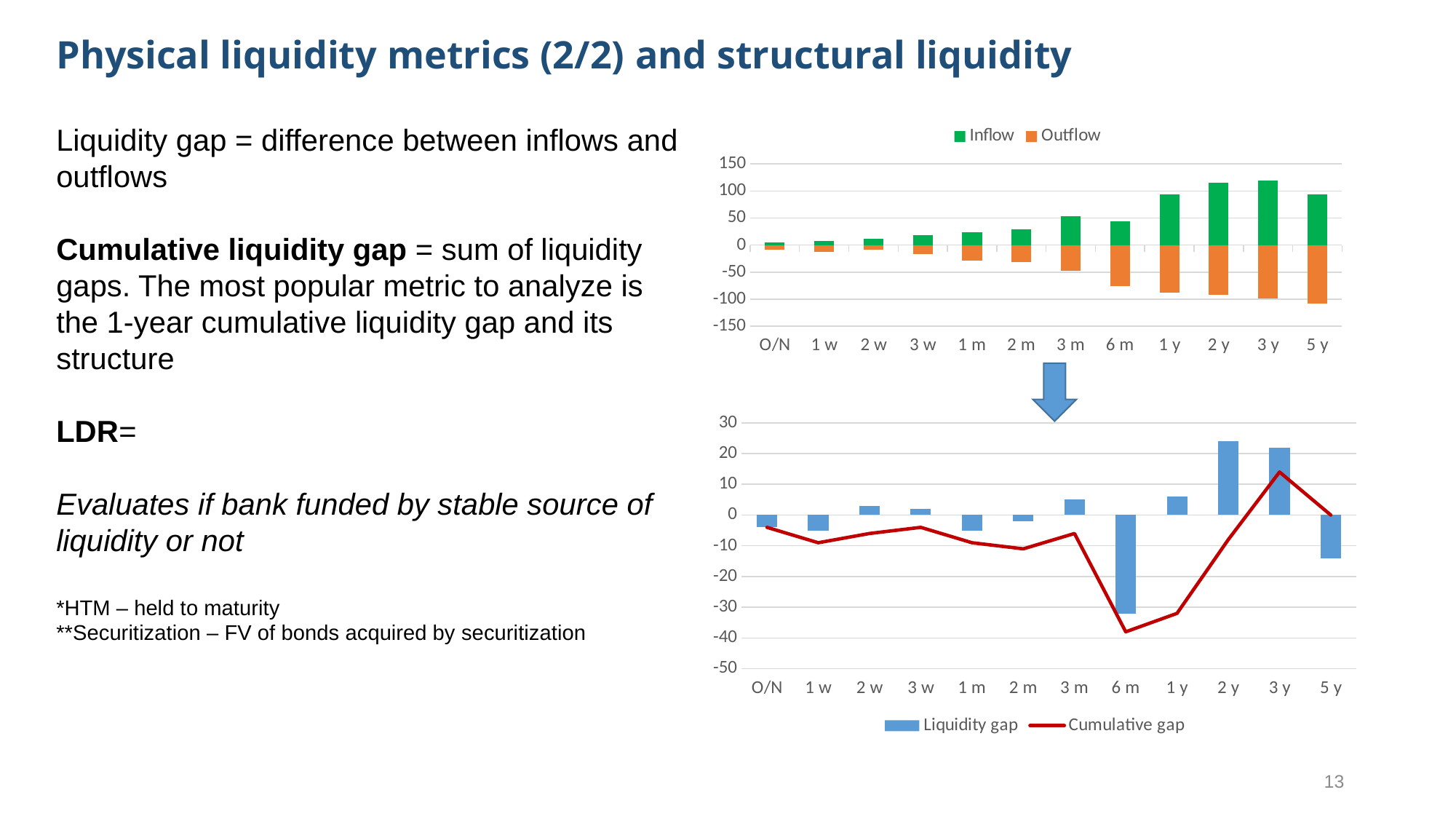
In the top chart, which series is shown in green? Inflow In the bottom chart, is the Liquidity gap for 6 m greater or less than -20? less How many series does the legend of the top chart list? 2 In the bottom chart, which series is drawn as a red line? Cumulative gap What kind of chart is the top chart (Inflow/Outflow)? bar chart In the top chart, is the Outflow value for 6 m greater or less than -50? less In the bottom chart, which category has the highest Cumulative gap? 3 y In the top chart, is the Inflow value for 2 m greater or less than 50? less In the bottom chart, which category has the lowest Liquidity gap? 6 m In the bottom chart, which is larger, the Liquidity gap for 2 y or for 6 m? 2 y How many categories are shown on the x axis of the top chart? 12